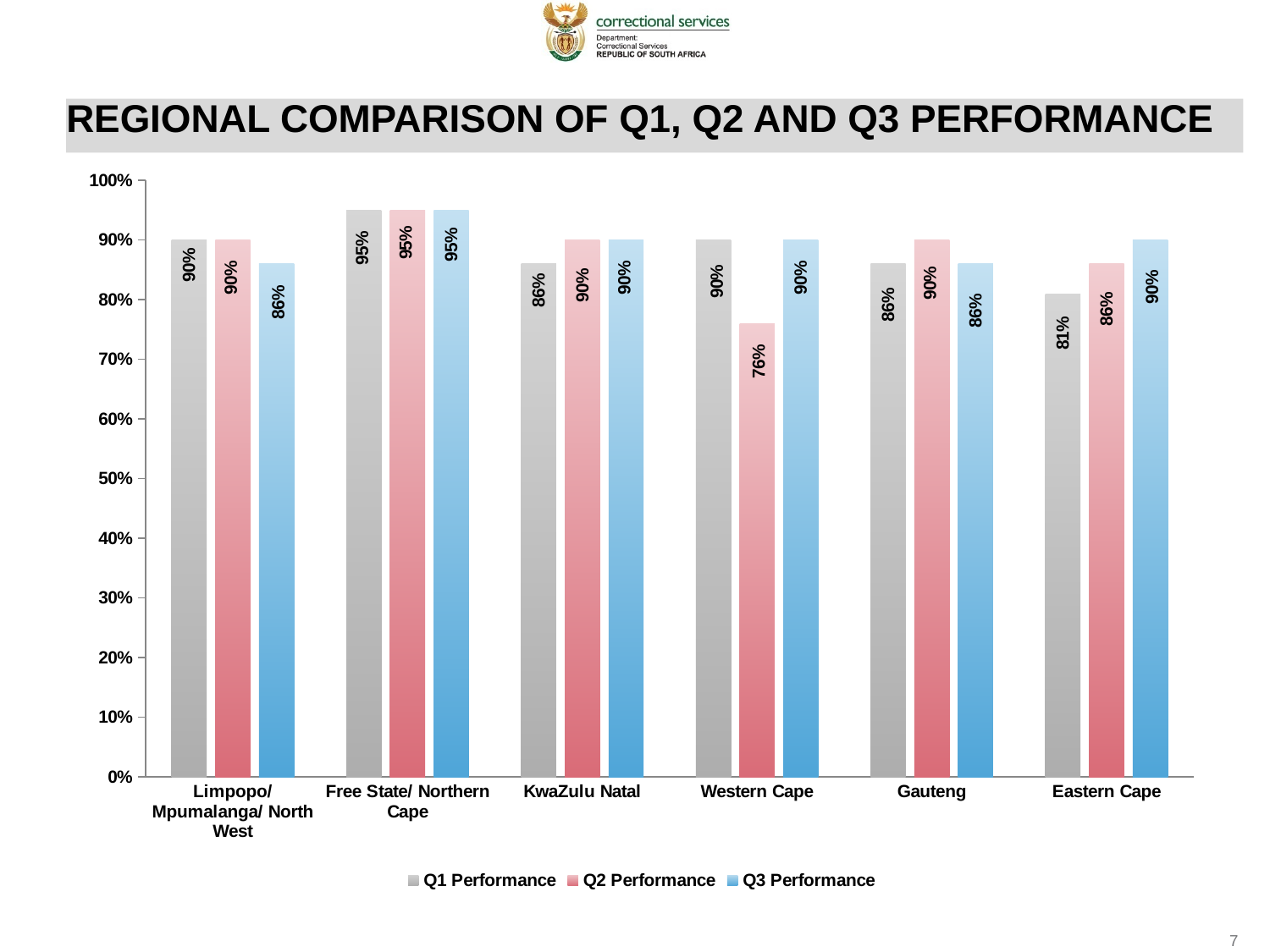
Which is larger for KwaZulu Natal: Q1 Performance or Q3 Performance? Q3 Performance Is the Q2 Performance value for Western Cape greater or less than 80%? less What is the Q1 Performance value for Eastern Cape? 81% Which region has the highest Q1 Performance? Free State/ Northern Cape What is the difference between the Q3 Performance and Q2 Performance for Western Cape? 14% What kind of chart is shown on the slide? Bar chart What is the Q2 Performance value for Western Cape? 76% Which region has the lowest Q2 Performance? Western Cape What is the title of the chart? REGIONAL COMPARISON OF Q1, Q2 AND Q3 PERFORMANCE How many series does the legend list? 3 What is the Q3 Performance value for Gauteng? 86% How many regions are shown on the x axis? 6